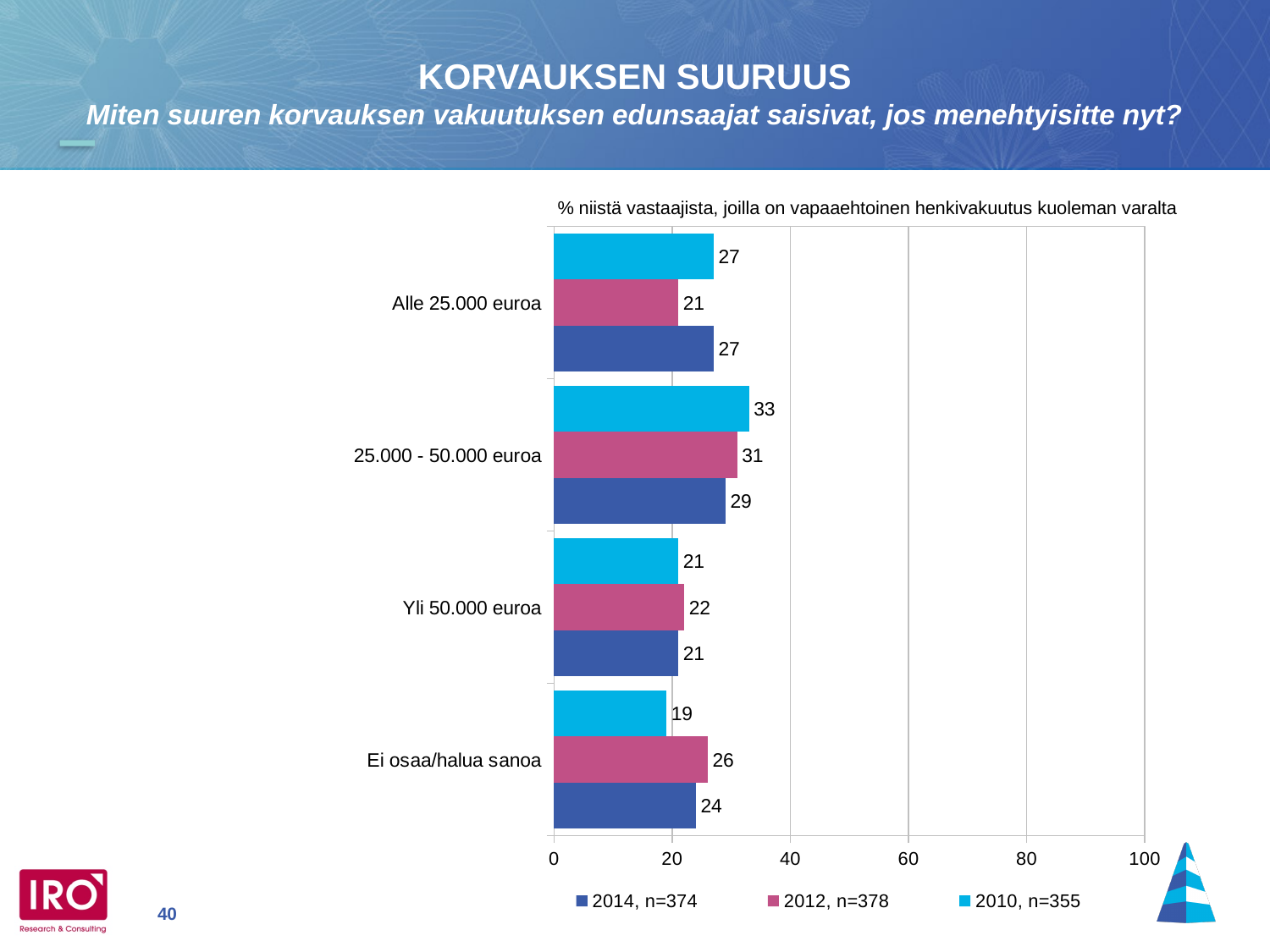
Which category has the lowest 2012 value? Alle 25.000 euroa For "Alle 25.000 euroa", which is larger: the 2014 value or the 2012 value? 2014 Which category has the highest 2010 value? 25.000 - 50.000 euroa What is the 2010 value for "Alle 25.000 euroa"? 27 What kind of chart is shown on the slide? bar chart What is the 2014 value for "25.000 - 50.000 euroa"? 29 Is the 2010 value for "25.000 - 50.000 euroa" greater or less than 40? less What is the 2010 value for "Yli 50.000 euroa"? 21 How many series does the legend list? 3 How many categories are shown on the chart? 4 What is the difference between the 2012 and 2010 values for "Ei osaa/halua sanoa"? 7 What is the 2012 value for "Ei osaa/halua sanoa"? 26